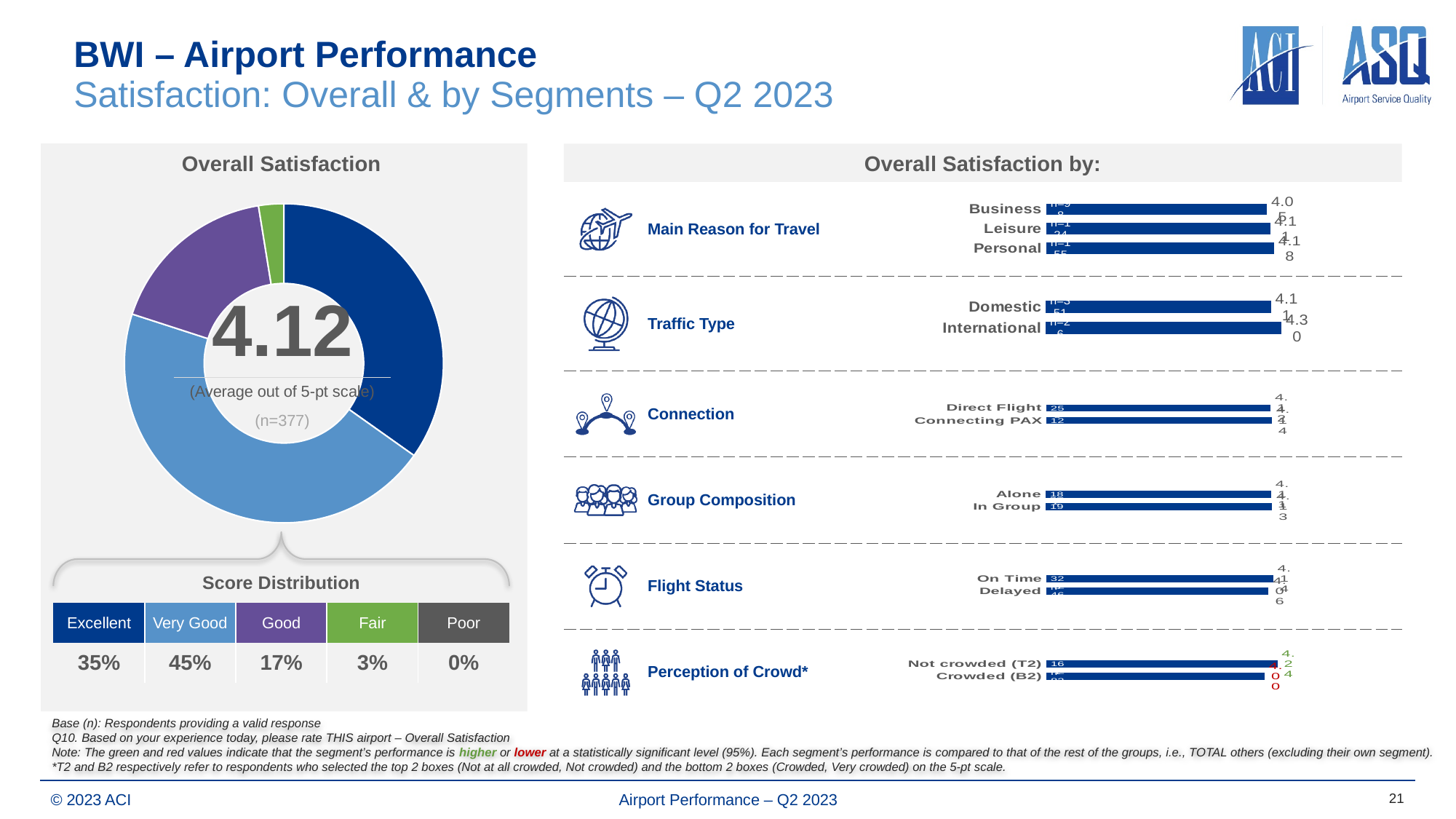
In the Score Distribution, what percentage of respondents rated the airport Good? 17% What type of chart is the Overall Satisfaction chart on the left? Donut chart In the Score Distribution, what is the difference between the Very Good and Excellent percentages? 10% On the Overall Satisfaction donut chart, what is the overall satisfaction score shown in the centre? 4.12 In the Score Distribution, what percentage of respondents rated the airport Excellent? 35% In the Score Distribution, which rating category has the highest share? Very Good In the Perception of Crowd chart, which segment has the higher satisfaction score, Not crowded (T2) or Crowded (B2)? Not crowded (T2) How many rating categories are shown in the Score Distribution? 5 What is the sample size (n) shown on the Overall Satisfaction chart? n=377 In the Traffic Type chart, which segment has the higher satisfaction score, Domestic or International? International In the Score Distribution, what percentage of respondents rated the airport Very Good? 45% In the Score Distribution, which rating category has the lowest share? Poor